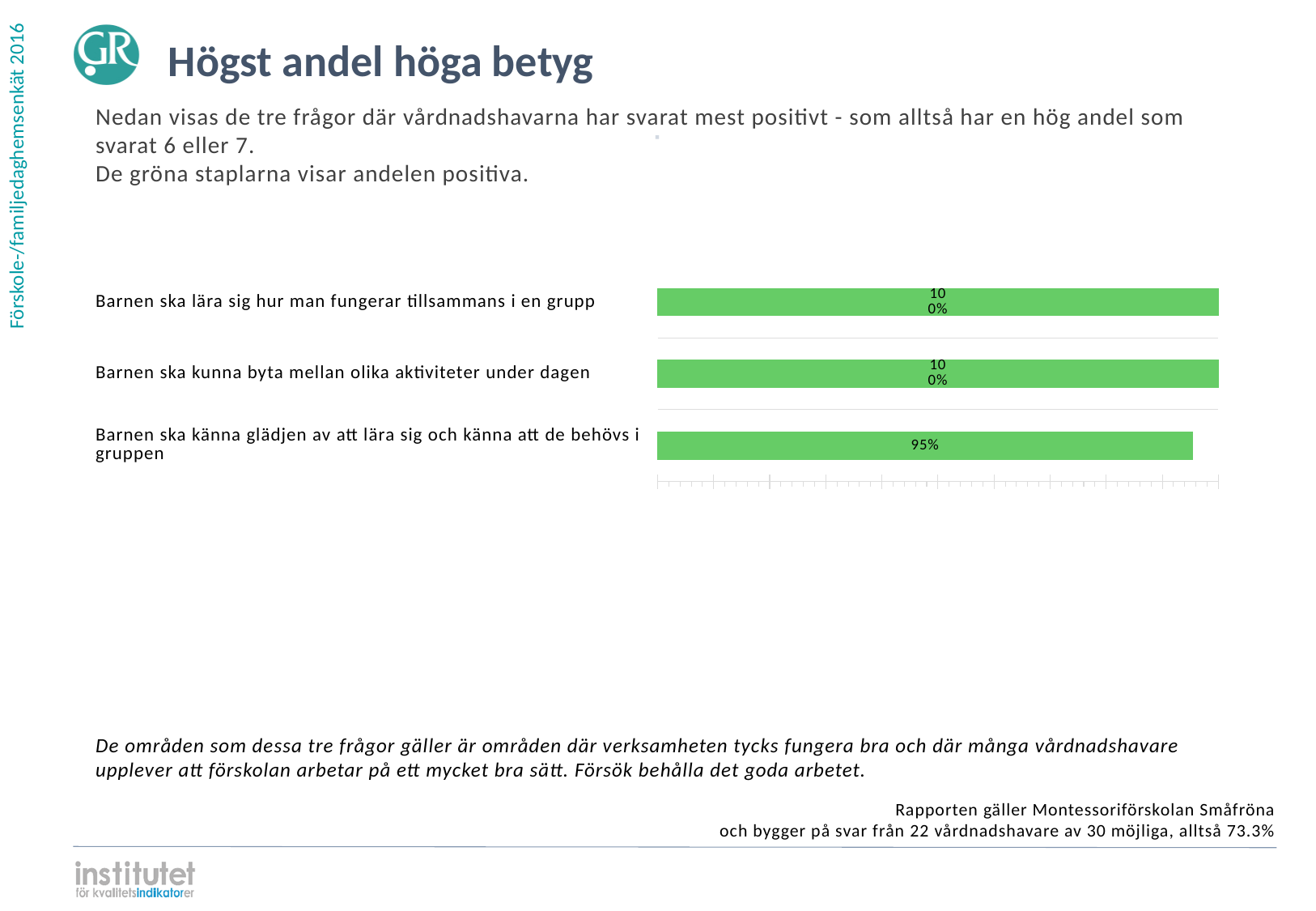
What kind of chart is shown on the slide? Bar chart What is the difference between the value for "Barnen ska lära sig hur man fungerar tillsammans i en grupp" and the value for "Barnen ska känna glädjen av att lära sig och känna att de behövs i gruppen"? 5% How many categories are shown in the chart? 3 Which category has the lowest value? Barnen ska känna glädjen av att lära sig och känna att de behövs i gruppen Which is larger: the value for "Barnen ska kunna byta mellan olika aktiviteter under dagen" or the value for "Barnen ska känna glädjen av att lära sig och känna att de behövs i gruppen"? Barnen ska kunna byta mellan olika aktiviteter under dagen What is the value for "Barnen ska kunna byta mellan olika aktiviteter under dagen"? 100% What is the value for "Barnen ska lära sig hur man fungerar tillsammans i en grupp"? 100% What is the title of the slide containing the chart? Högst andel höga betyg What is the value for "Barnen ska känna glädjen av att lära sig och känna att de behövs i gruppen"? 95% What colour are the bars in the chart? Green